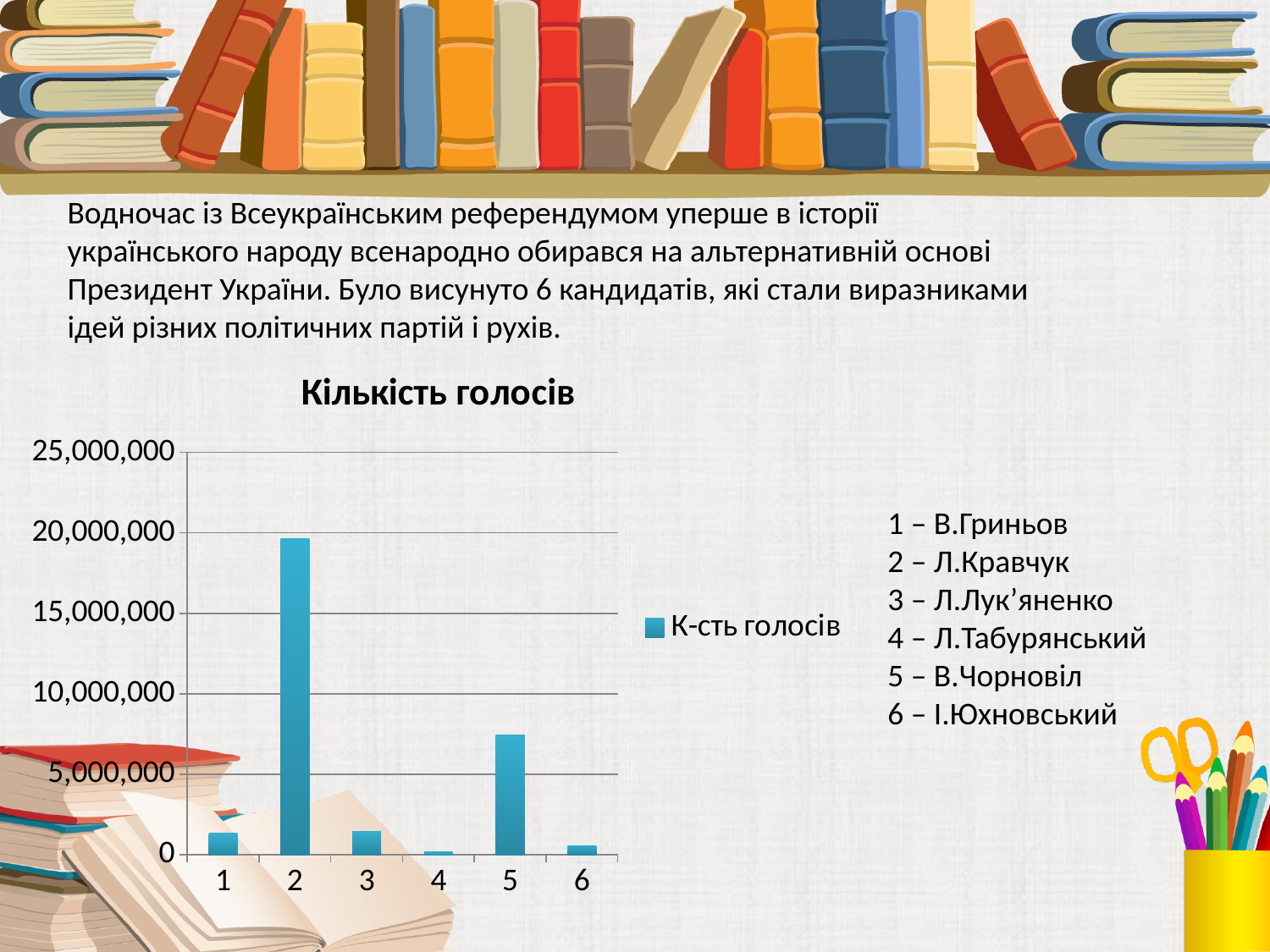
Which has a larger value, category 5 or category 3? 5 Is the value for category 5 greater or less than 10,000,000? less Which category has the highest number of votes in the chart? 2 What type of chart is shown on the slide? bar chart Is the value for category 1 greater or less than 5,000,000? less What is the name of the series shown in the chart legend? К-сть голосів Which category has the lowest number of votes in the chart? 4 Is the value for category 2 greater or less than 15,000,000? greater What is the title of the chart? Кількість голосів How many categories are plotted on the x axis of the chart? 6 How many series does the chart legend list? 1